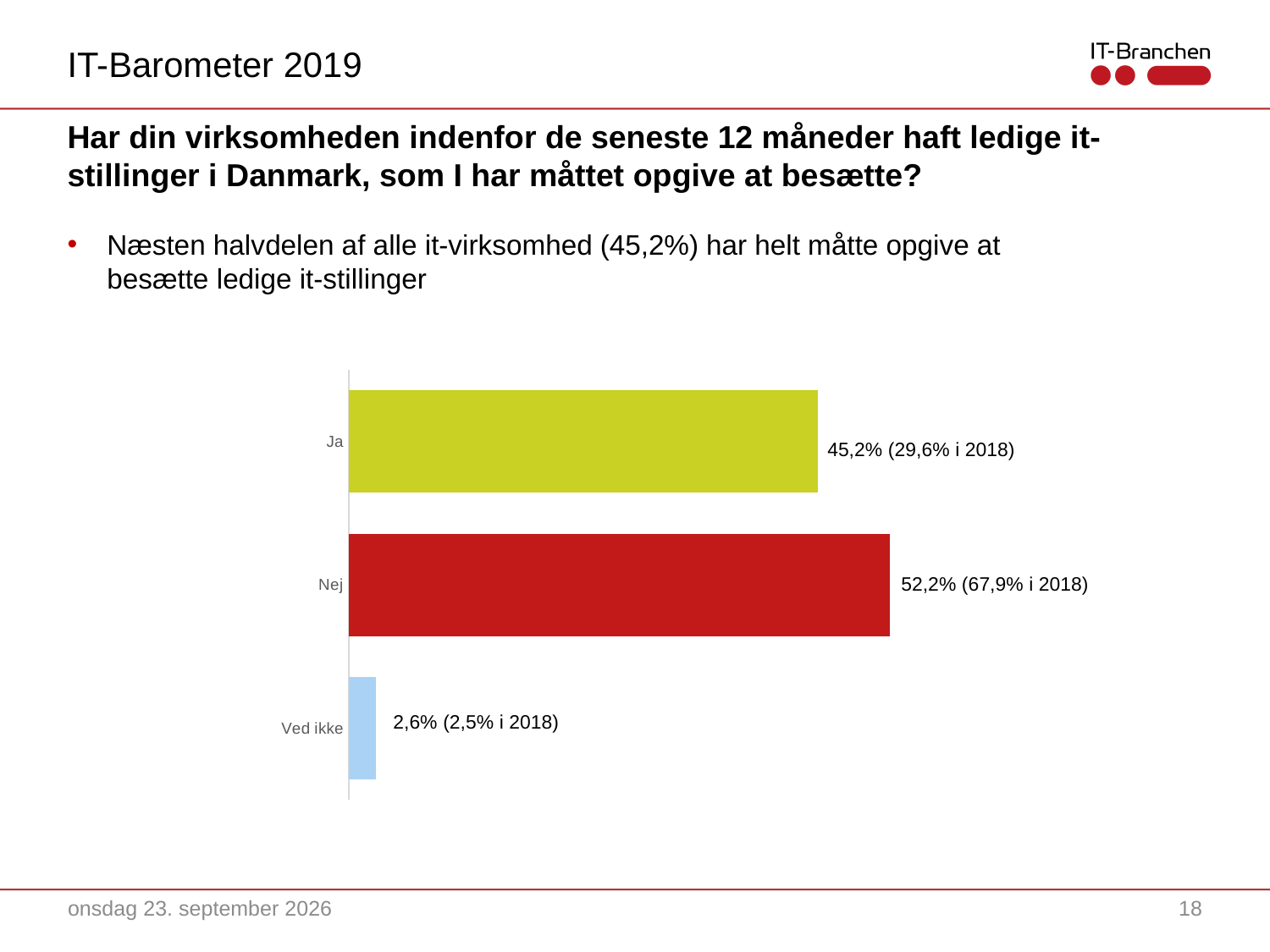
How many categories are shown in the chart? 3 What colour is the bar for "Nej"? Red What kind of chart is shown on the slide? Bar chart What is the difference between the values for "Nej" and "Ja"? 7,0% What was the 2018 value for "Ja" according to the data label? 29,6% What was the 2018 value for "Nej" according to the data label? 67,9% Which category has the lowest value in the chart? Ved ikke What is the value for "Ja" in the chart? 45,2% What is the value for "Ved ikke" in the chart? 2,6% What is the value for "Nej" in the chart? 52,2% Which is larger, the value for "Ja" or the value for "Nej"? Nej Which category has the highest value in the chart? Nej